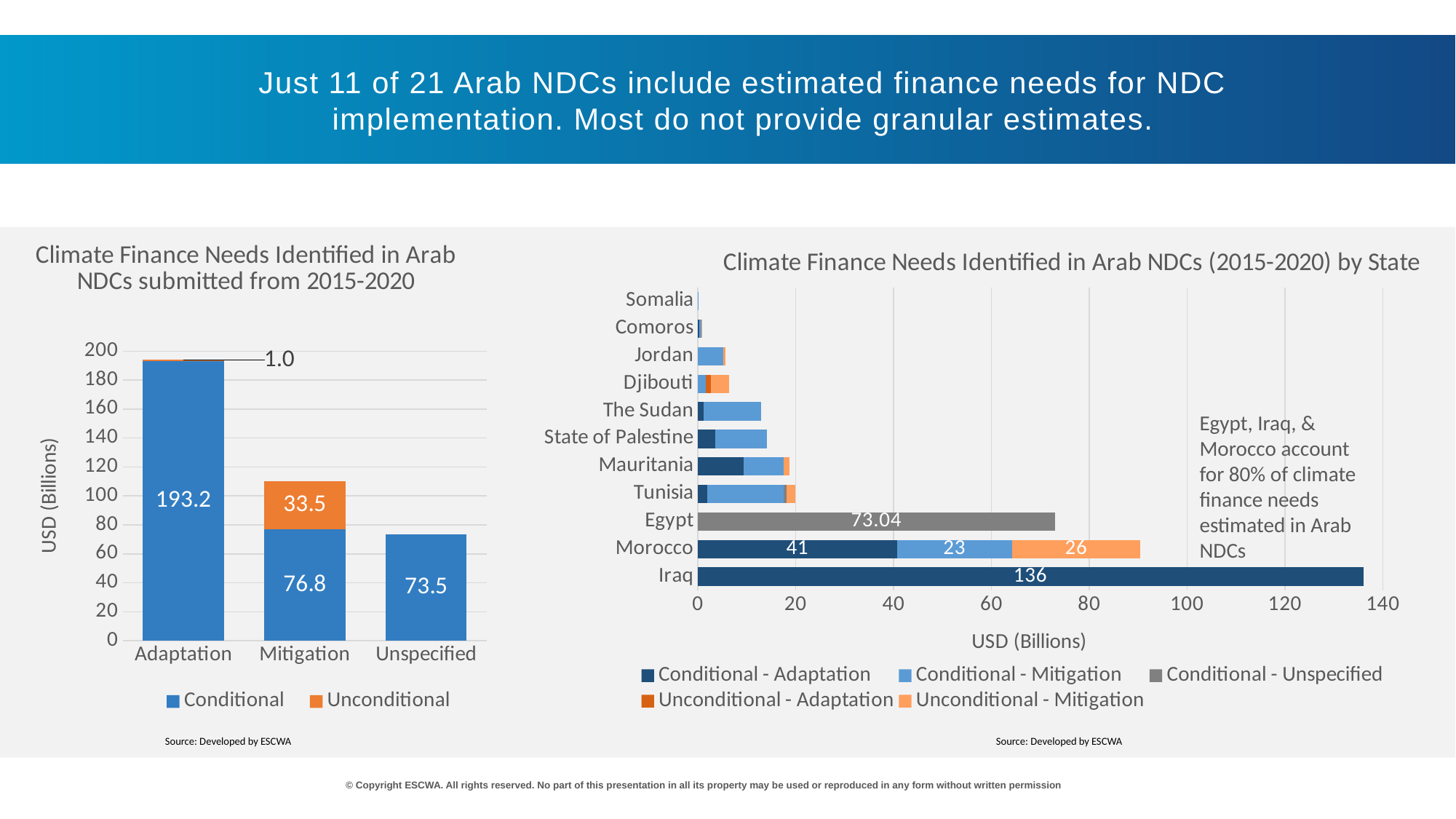
In the left chart, what is the difference between the Conditional values for Mitigation and Unspecified? 3.3 In the right chart, which state has the longest bar? Iraq In the left chart (Climate Finance Needs Identified in Arab NDCs submitted from 2015-2020), what is the Conditional value for Adaptation? 193.2 In the left chart, how many series does the legend list? 2 In the right chart, what is the Conditional - Unspecified value for Egypt? 73.04 In the right chart (Climate Finance Needs Identified in Arab NDCs (2015-2020) by State), what is the Conditional - Adaptation value for Iraq? 136 In the right chart, what is the total of the stacked bar for Morocco? 90 In the left chart, what is the Conditional value for Unspecified? 73.5 In the left chart, what is the total of the stacked bar for Mitigation? 110.3 In the left chart, what is the Unconditional value for Mitigation? 33.5 In the right chart, is the total value for Tunisia greater or less than 40? less In the right chart, how many states are listed on the vertical axis? 11